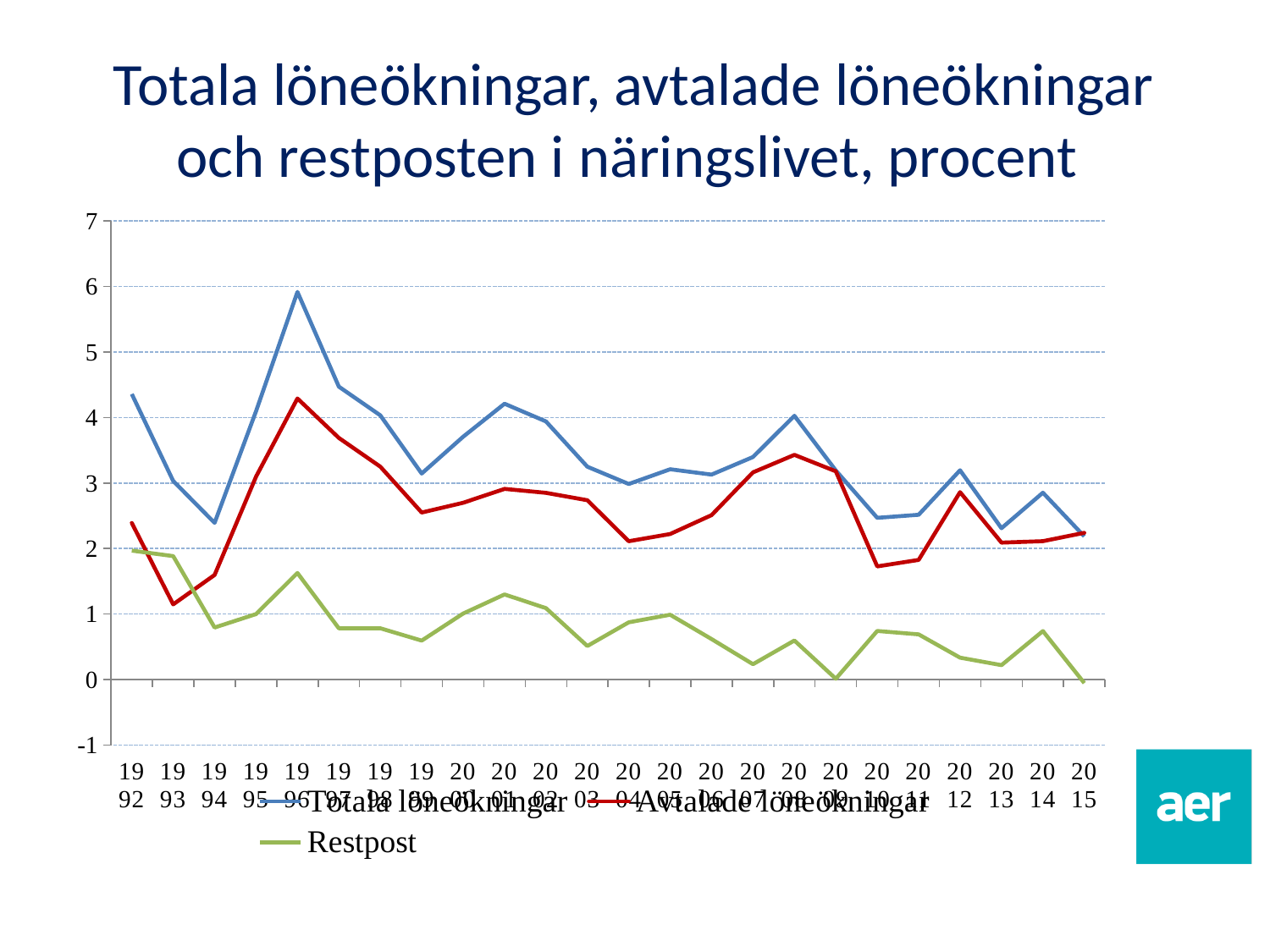
Does the Restpost series overall rise or fall from 1992 to 2015? fall Is the value for Avtalade löneökningar in 1993 greater or less than 2? less In which year does the Totala löneökningar series reach its highest value? 1996 Is the value for Totala löneökningar in 1994 greater or less than 3? less Which series is drawn in green? Restpost In which year does the Avtalade löneökningar series reach its lowest value? 1993 Is the value for Totala löneökningar in 1996 greater or less than 5? greater How many years are plotted along the x axis? 24 What kind of chart is shown on the slide? line chart In 1996, which series has the larger value: Totala löneökningar or Avtalade löneökningar? Totala löneökningar How many series does the legend list? 3